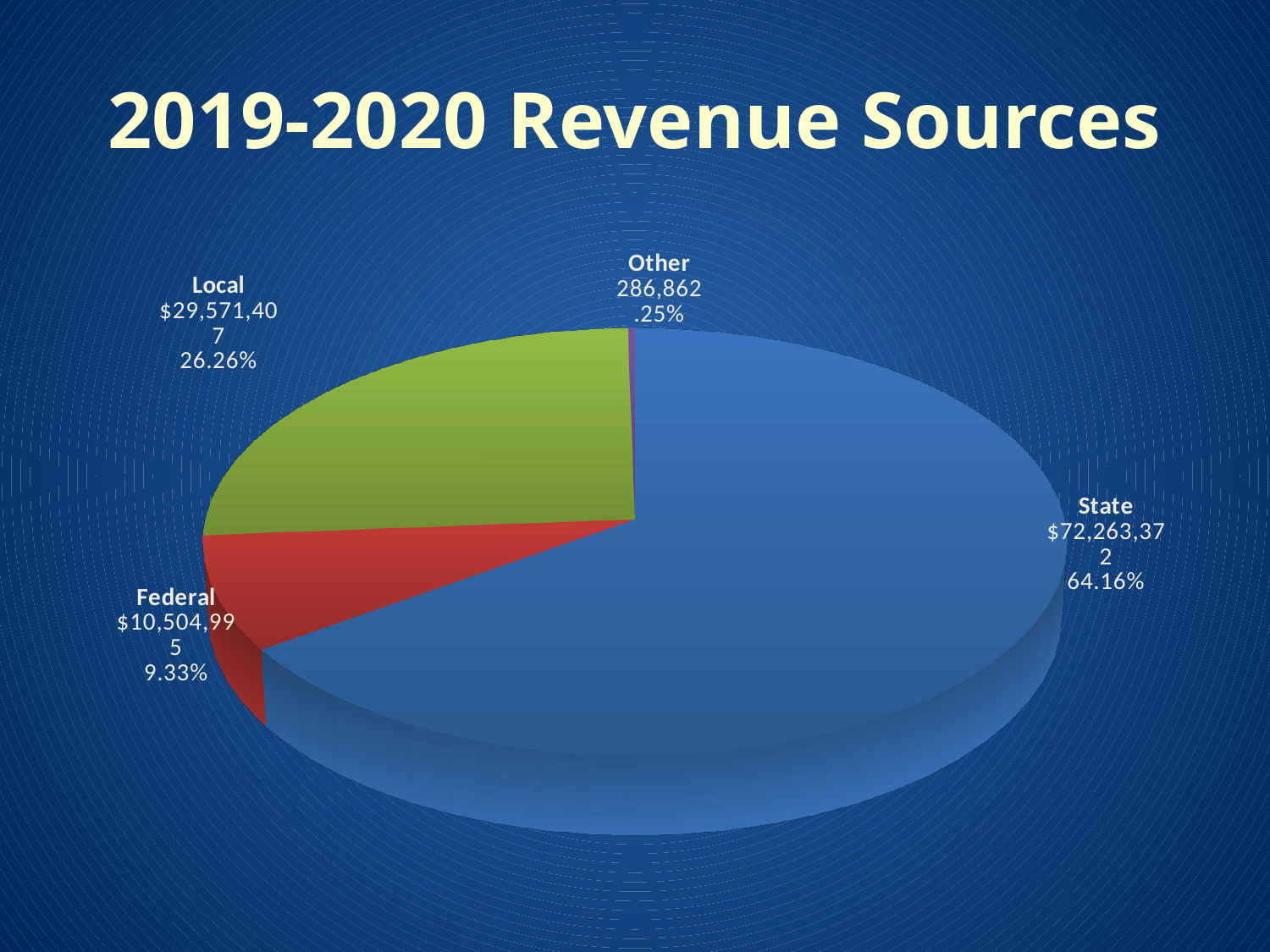
What kind of chart is shown on the slide? pie chart What share of the pie does Federal revenue represent? 9.33% What is the dollar value shown for Local revenue? $29,571,407 What value is shown for the Other revenue source? 286,862 What is the dollar value shown for Federal revenue? $10,504,995 Which revenue source is the smallest? Other How many revenue sources (slices) does the pie chart show? 4 Which revenue source is the largest? State What share of the pie does State revenue represent? 64.16% What is the title of the chart? 2019-2020 Revenue Sources What is the dollar value shown for State revenue? $72,263,372 Which is larger, Local revenue or Federal revenue? Local